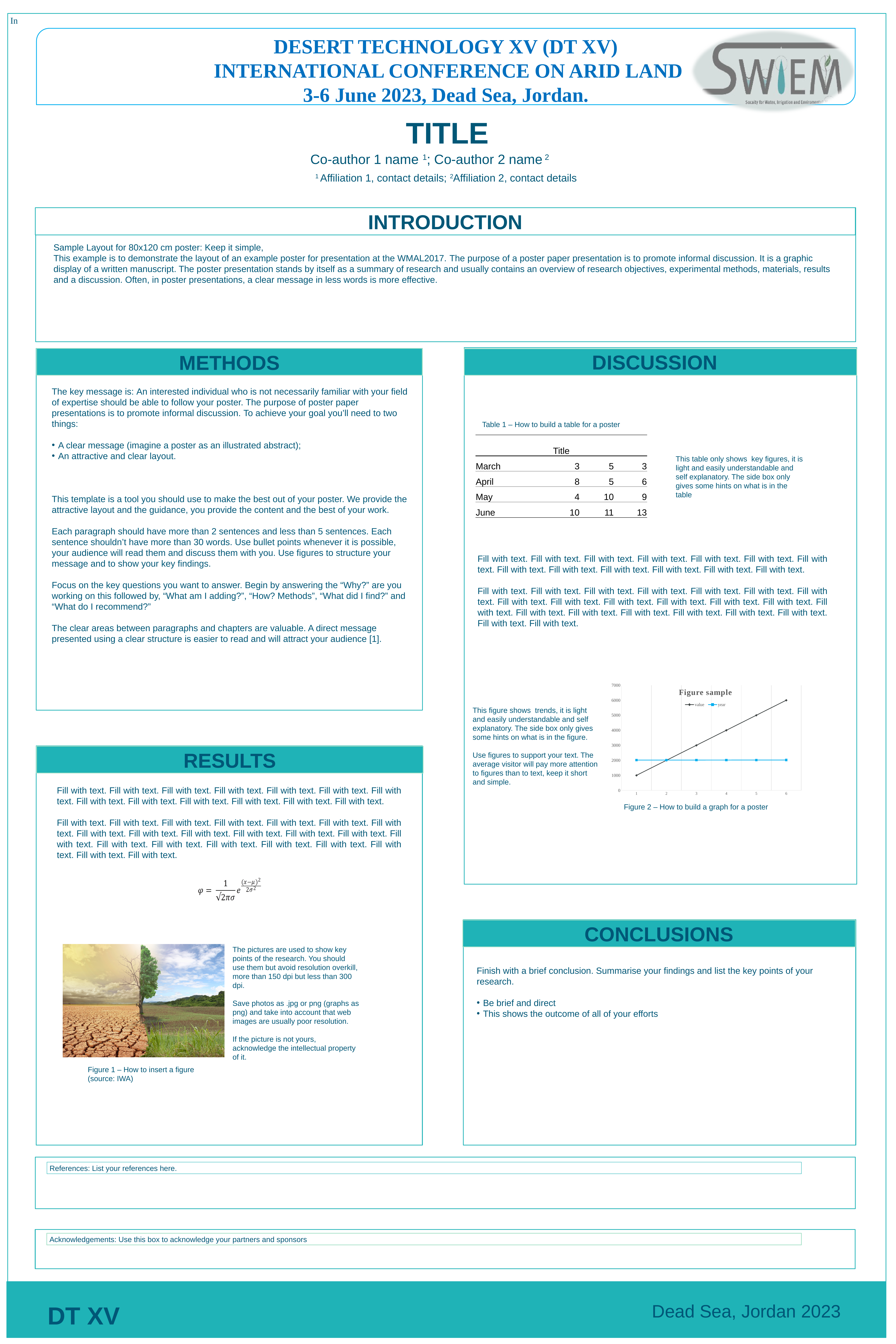
How many x-axis points are plotted for each series in the "Figure sample" chart? 6 What kind of chart is the "Figure sample" chart? line chart In the "Figure sample" chart, what is the value series at x = 6? 6000 In the "Figure sample" chart, does the year series rise, fall or stay flat across the x axis? stay flat In the "Figure sample" chart, which series is higher at x = 6, value or year? value What are the two series named in the legend of the "Figure sample" chart? value and year In the "Figure sample" chart, is the value series at x = 5 greater or less than 4000? greater In the "Figure sample" chart, does the value series rise or fall as x goes from 1 to 6? rise How many series does the legend of the "Figure sample" chart list? 2 In the "Figure sample" chart, what is the value series at x = 1? 1000 What is the title of the chart in the Discussion section? Figure sample